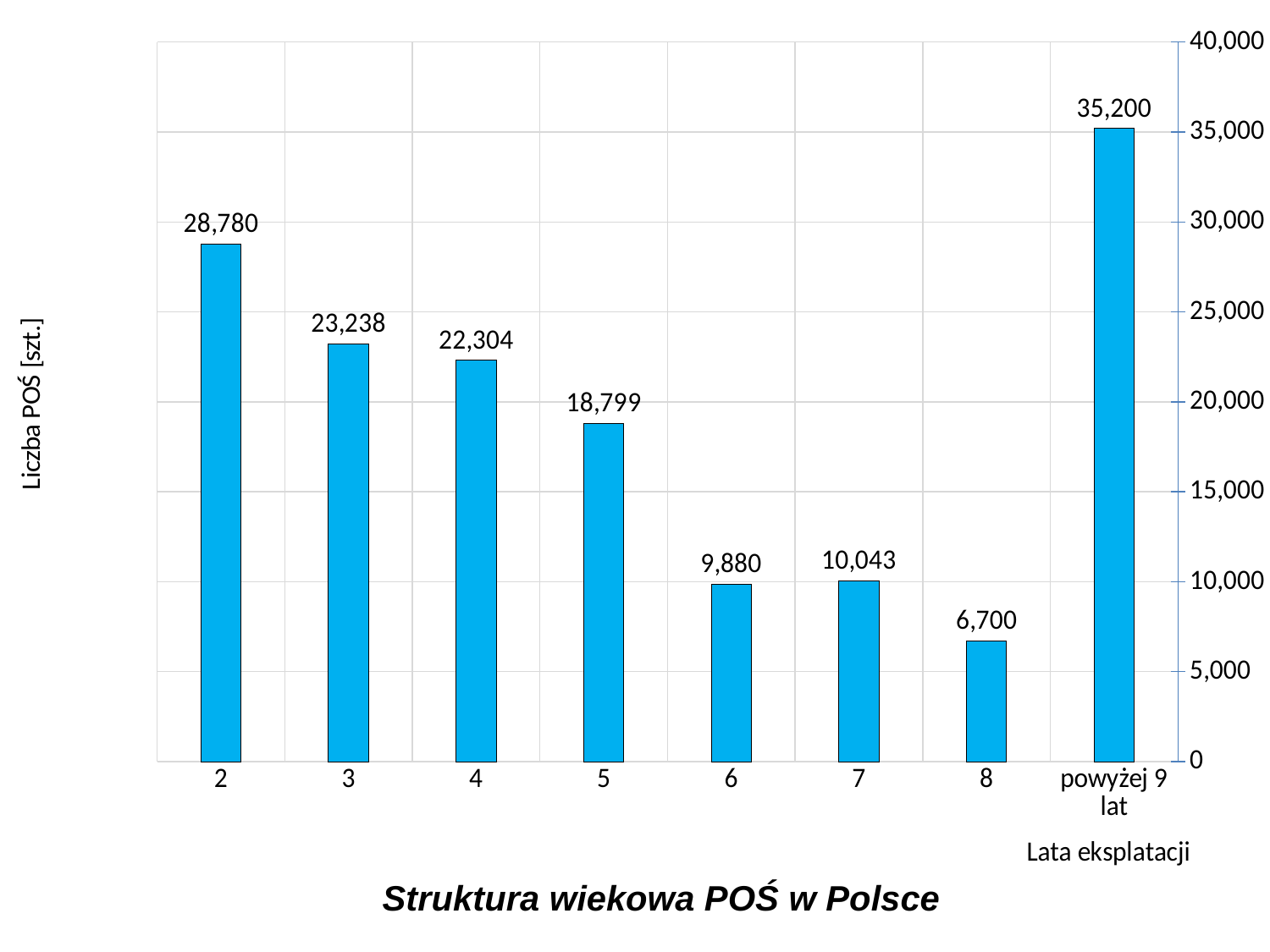
What is the value for category 2? 28,780 Which category has the highest value? powyżej 9 lat What is the value for category 5? 18,799 Which category has the lowest value? 8 What kind of chart is this? bar chart Is the value for category 8 greater or less than 10,000? less Do the values rise or fall from category 2 to category 5? fall How many categories are shown on the x axis? 8 What is the difference between the values for category 3 and category 4? 934 Which is larger, the value for category 6 or category 7? 7 What is the title of the chart? Struktura wiekowa POŚ w Polsce What is the value for 'powyżej 9 lat'? 35,200